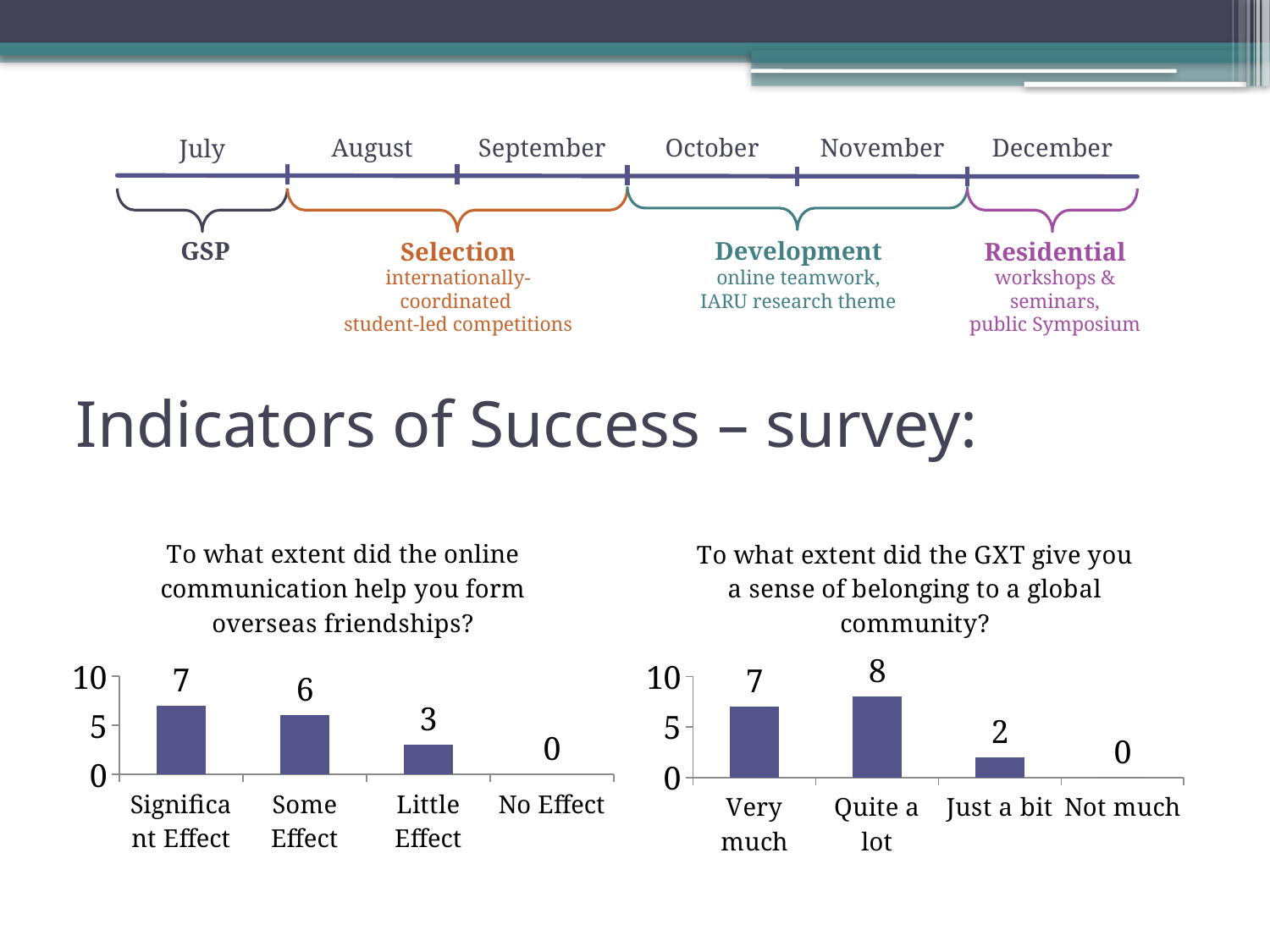
In the left chart (online communication and overseas friendships), what is the value for Significant Effect? 7 In the right chart (GXT and sense of belonging to a global community), what is the value for Quite a lot? 8 In the left chart (online communication and overseas friendships), which category has the lowest value? No Effect In the left chart (online communication and overseas friendships), which category has the highest value? Significant Effect In the right chart (GXT and sense of belonging to a global community), which is larger: Very much or Just a bit? Very much In the right chart (GXT and sense of belonging to a global community), what is the difference between Quite a lot and Very much? 1 In the left chart (online communication and overseas friendships), what is the difference between Some Effect and Little Effect? 3 In the left chart (online communication and overseas friendships), what is the value for Little Effect? 3 In the left chart (online communication and overseas friendships), how many categories are shown on the x axis? 4 In the right chart (GXT and sense of belonging to a global community), what is the value for Just a bit? 2 In the right chart (GXT and sense of belonging to a global community), which category has the highest value? Quite a lot What type of chart is the right chart (GXT and sense of belonging to a global community)? Bar chart